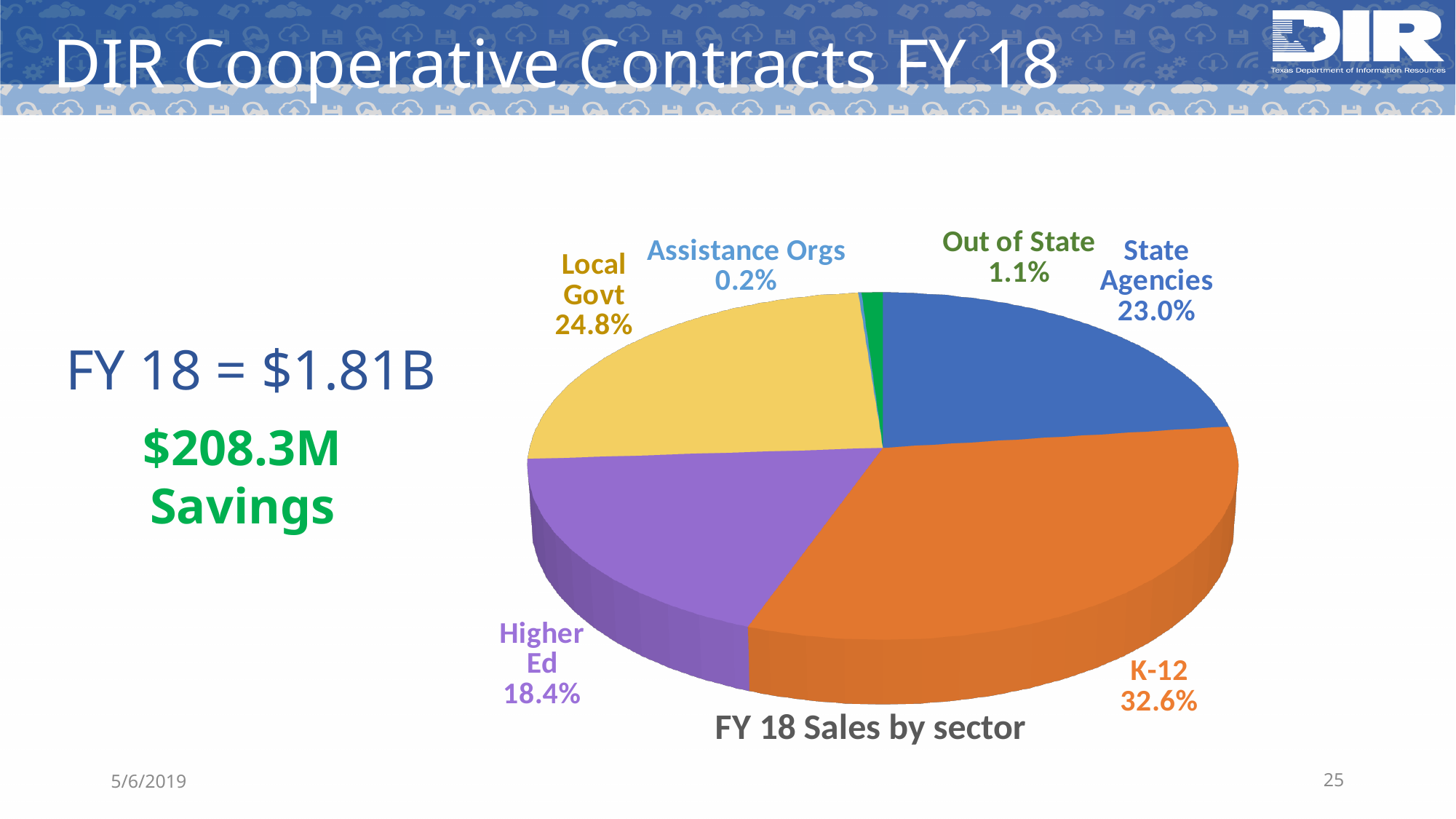
What percentage of sales comes from Higher Ed? 18.4% How many sectors are shown in the pie chart? 6 What percentage of FY 18 sales is attributed to State Agencies? 23.0% What type of chart is used to show FY 18 Sales by sector? Pie chart What share of sales is from Assistance Orgs? 0.2% Which sector has the smallest share of FY 18 sales? Assistance Orgs How many percentage points larger is the K-12 share than the State Agencies share? 9.6 Which has a larger share of sales, Local Govt or Higher Ed? Local Govt What share of FY 18 sales does K-12 account for? 32.6% What is the title of the chart? FY 18 Sales by sector What is the share for Local Govt in the FY 18 Sales by sector chart? 24.8% Which sector has the largest share of FY 18 sales? K-12